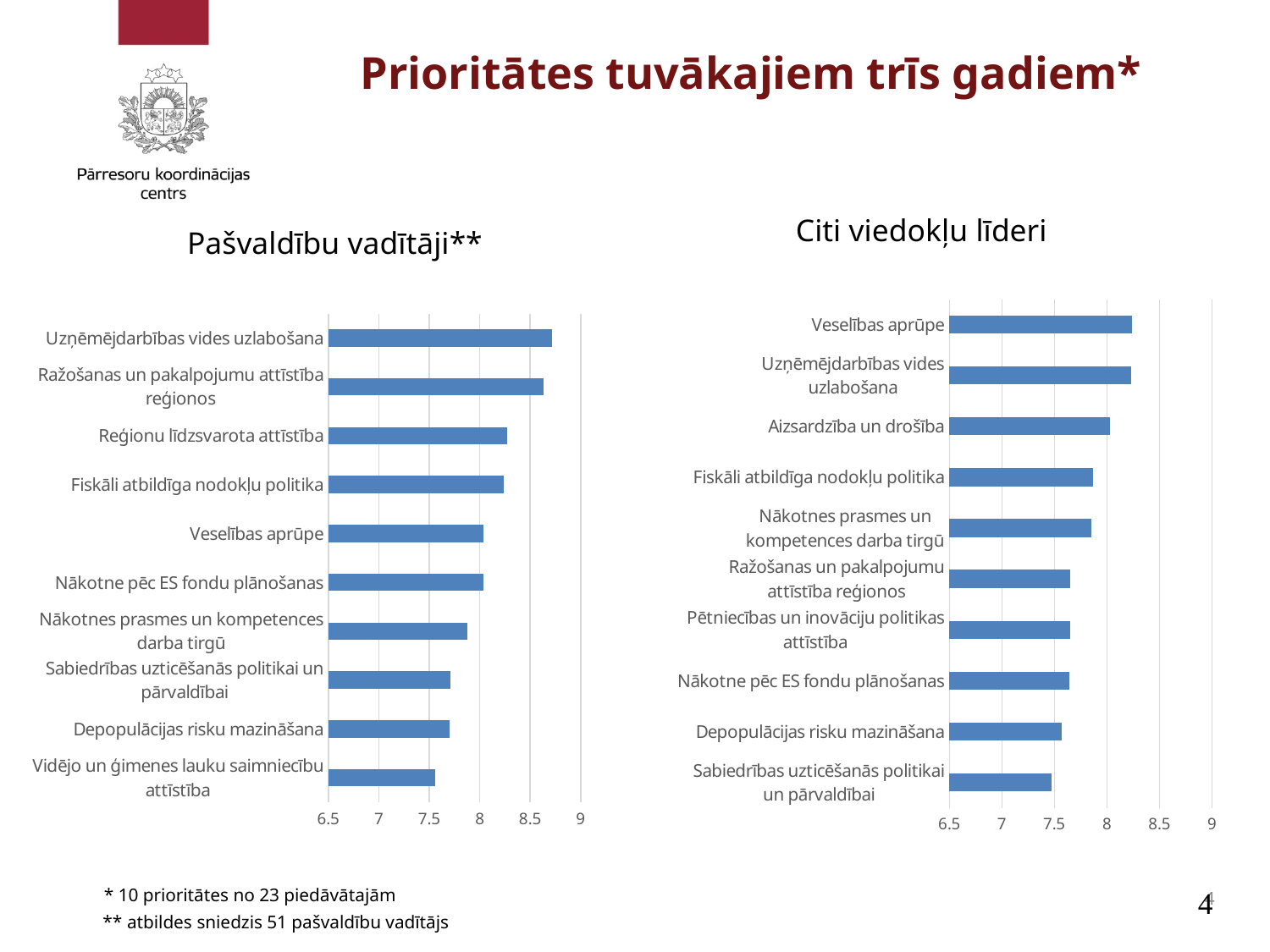
What type of chart is used for the 'Pašvaldību vadītāji**' chart on the left? bar chart In the 'Citi viedokļu līderi' chart, which is larger: the value for 'Veselības aprūpe' or for 'Depopulācijas risku mazināšana'? Veselības aprūpe In the 'Pašvaldību vadītāji**' chart, which priority has the lowest value? Vidējo un ģimenes lauku saimniecību attīstība What is the title of the slide containing the two charts? Prioritātes tuvākajiem trīs gadiem* In the 'Pašvaldību vadītāji**' chart, which is larger: the value for 'Reģionu līdzsvarota attīstība' or for 'Depopulācijas risku mazināšana'? Reģionu līdzsvarota attīstība In the 'Pašvaldību vadītāji**' chart, is the value for 'Sabiedrības uzticēšanās politikai un pārvaldībai' greater or less than 8? less In the 'Pašvaldību vadītāji**' chart, which priority has the highest value? Uzņēmējdarbības vides uzlabošana In the 'Citi viedokļu līderi' chart, how many priorities (categories) are plotted? 10 In the 'Pašvaldību vadītāji**' chart, is the value for 'Uzņēmējdarbības vides uzlabošana' greater or less than 8.5? greater In the 'Citi viedokļu līderi' chart, is the value for 'Ražošanas un pakalpojumu attīstība reģionos' greater or less than 8? less In the 'Pašvaldību vadītāji**' chart, how many priorities (categories) are plotted? 10